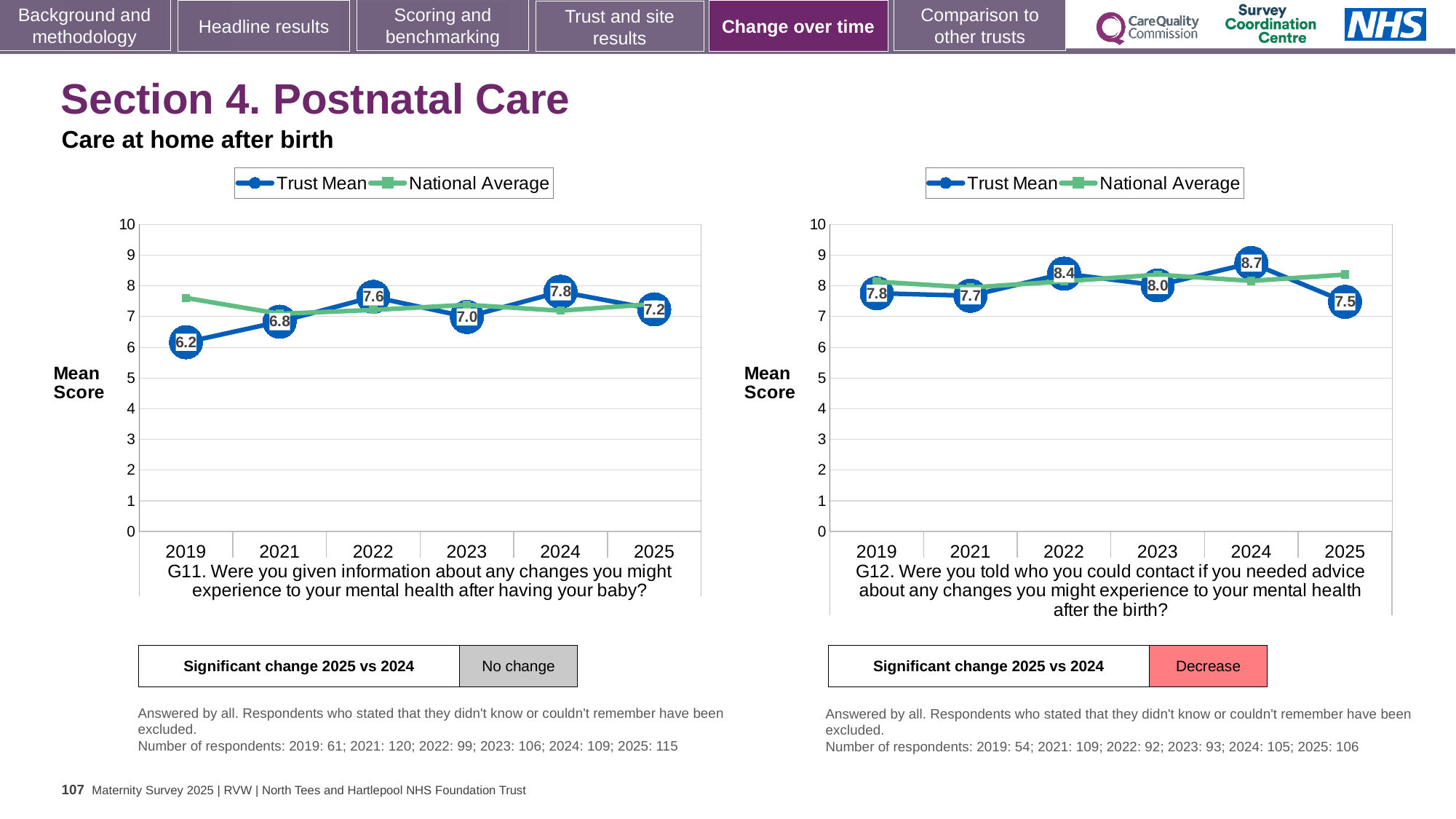
On the G11 chart (left), what is the Trust Mean for 2024? 7.8 On the G11 chart (left), how many series does the legend list? 2 On the G11 chart (left), which year has the lowest Trust Mean? 2019 On the G11 chart (left), what is the Trust Mean for 2019? 6.2 On the G12 chart (right), what is the Trust Mean for 2022? 8.4 On the G12 chart (right), is the Trust Mean higher in 2022 or in 2023? 2022 What type of chart is the G11 chart (left)? Line chart On the G12 chart (right), which year has the lowest Trust Mean? 2025 On the G12 chart (right), is the National Average for 2025 greater or less than 8? greater On the G11 chart (left), what is the difference between the Trust Mean in 2024 and in 2025? 0.6 How many years are plotted on the x axis of the G12 chart (right)? 6 On the G12 chart (right), which year has the highest Trust Mean? 2024